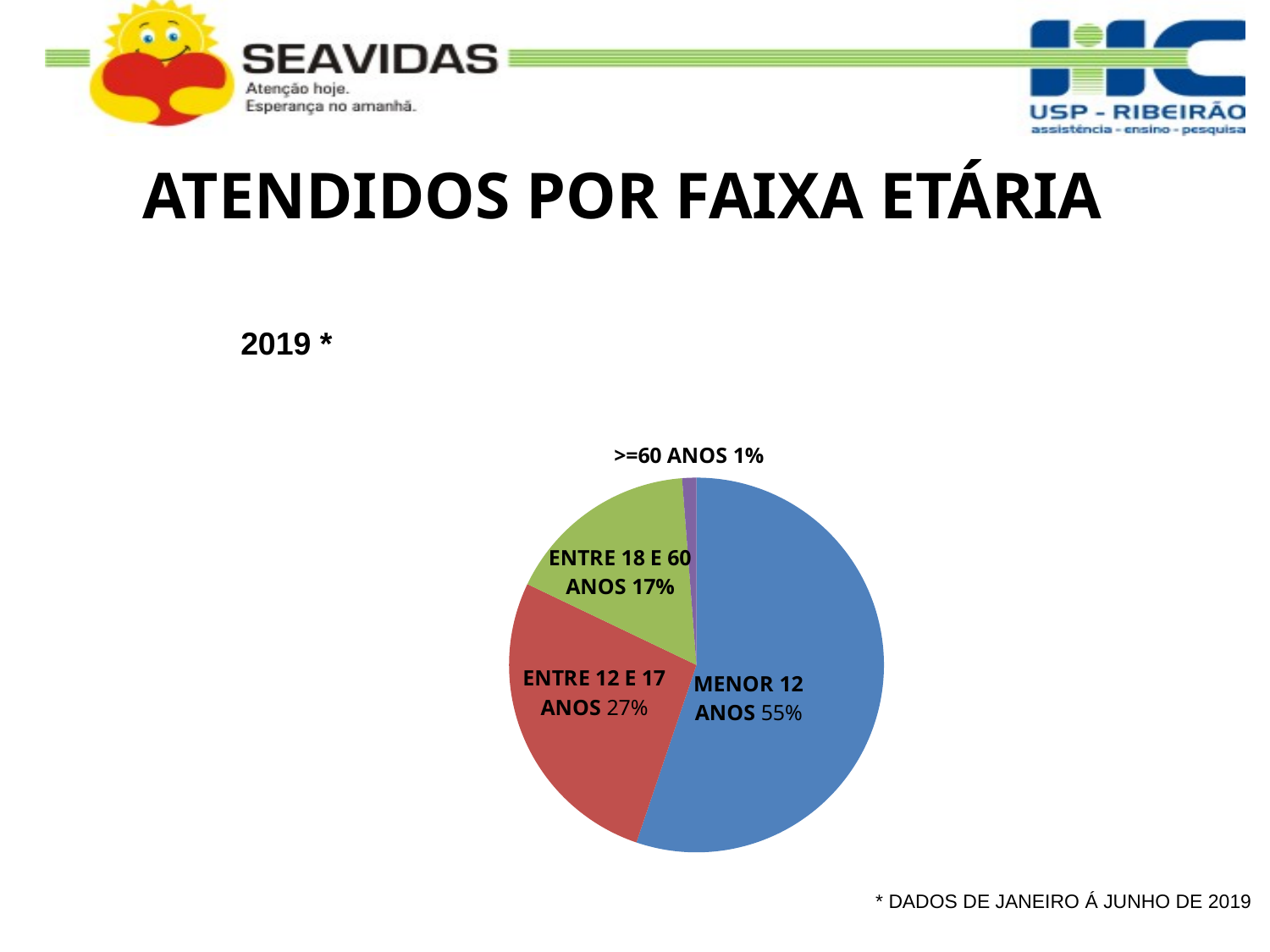
How many slices does the pie chart have? 4 What kind of chart is shown on the slide? pie chart What is the title of the slide containing the pie chart? ATENDIDOS POR FAIXA ETÁRIA Which is larger, the share for ENTRE 12 E 17 ANOS or the share for ENTRE 18 E 60 ANOS? ENTRE 12 E 17 ANOS What is the difference in percentage points between MENOR 12 ANOS and ENTRE 12 E 17 ANOS? 28 What colour is the slice for MENOR 12 ANOS? blue Which age group has the smallest slice of the pie? >=60 ANOS What share of the pie does >=60 ANOS represent? 1% What share of the pie does ENTRE 18 E 60 ANOS represent? 17% What share of the pie does ENTRE 12 E 17 ANOS represent? 27% Which age group has the largest slice of the pie? MENOR 12 ANOS